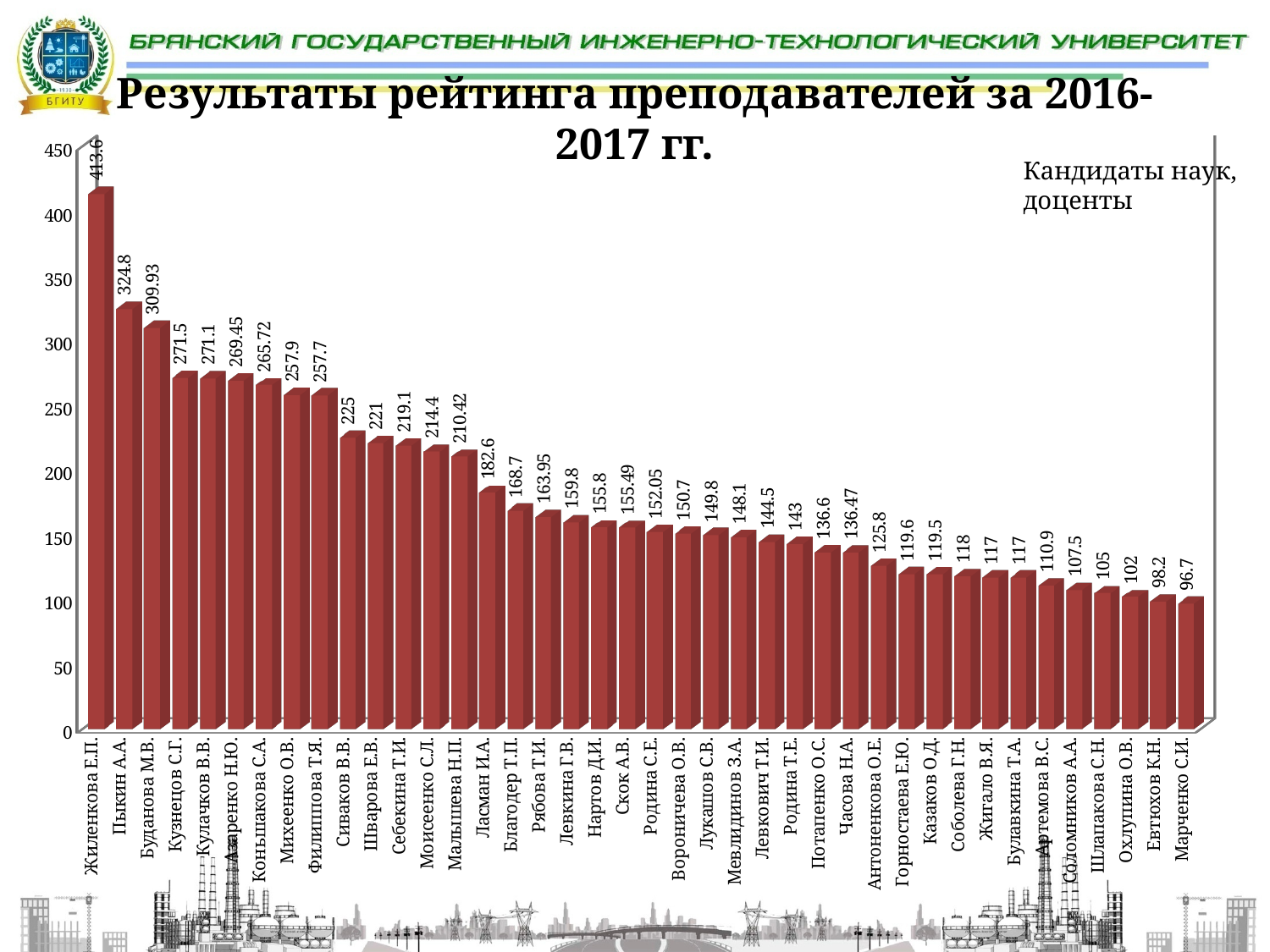
Which lecturer has the lowest rating on the chart? Марченко С.И. Which lecturer has the highest rating on the chart? Жиленкова Е.П. Do the values rise or fall from left to right along the x axis? fall What is the difference between the ratings of Жиленкова Е.П. and Пыкин А.А.? 88.8 What is the rating value for Буданова М.В.? 309.93 Which has a higher rating, Сиваков В.В. or Ласман И.А.? Сиваков В.В. What is the rating value for Малышева Н.П.? 210.42 Is the value for Антоненкова О.Е. greater or less than 150? less How many lecturers are shown on the chart? 40 What kind of chart is shown on the slide? bar chart What is the rating value for Родина Т.Е.? 143 What is the rating value for Жиленкова Е.П.? 413.6